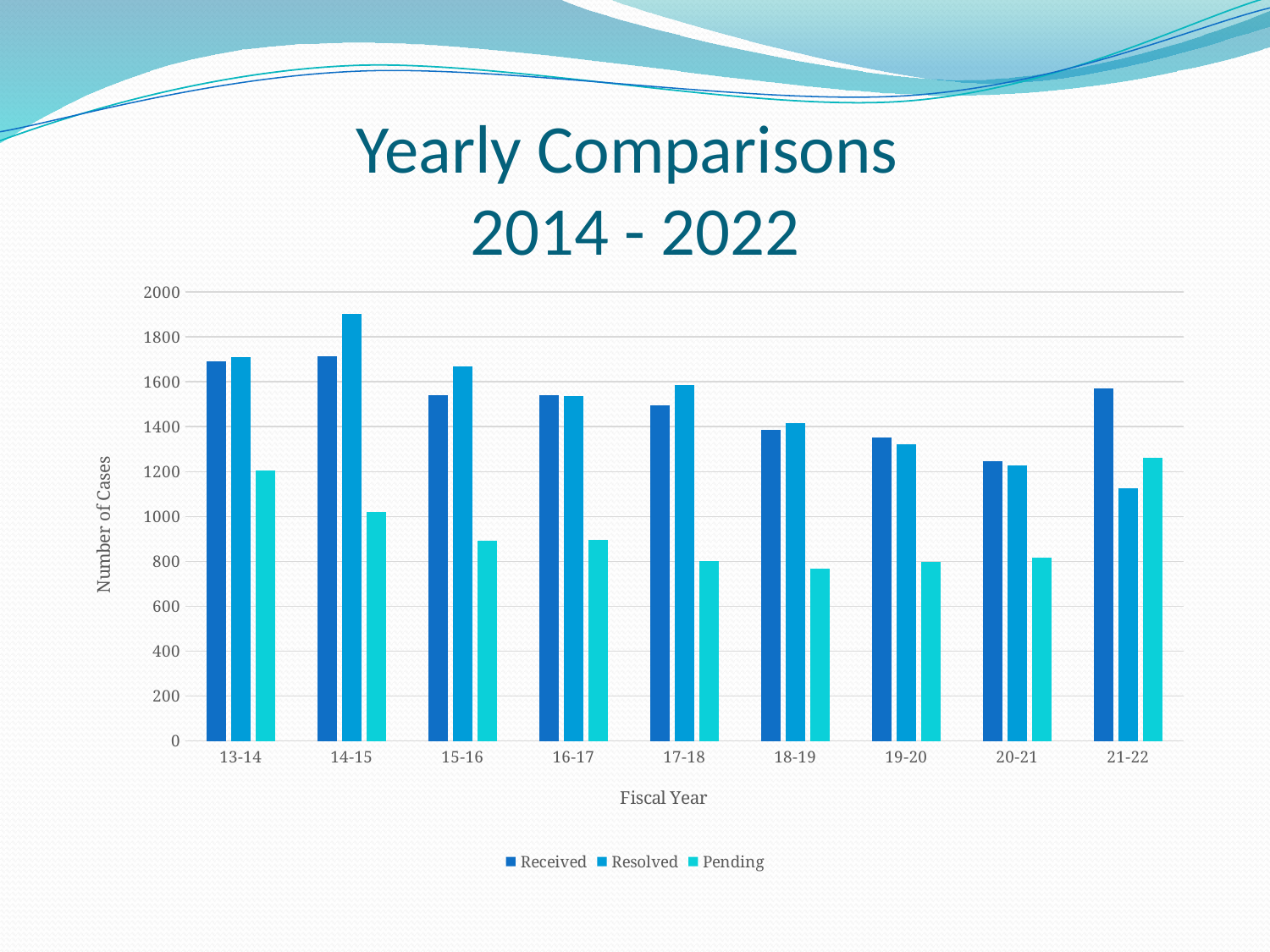
Is the Resolved value for 14-15 greater or less than 1800? greater Is the Pending value for 15-16 greater or less than 1000? less Does the Received value generally rise or fall from 13-14 to 20-21? Fall Is the Received value for 21-22 greater or less than 1400? greater What is the title of the vertical axis? Number of Cases How many fiscal years are shown on the x axis? 9 How many series does the legend list? 3 In which fiscal year is the Pending value highest? 21-22 In which fiscal year is the Resolved value lowest? 21-22 In which fiscal year is the Resolved value highest? 14-15 What kind of chart is shown on the slide? Bar chart In fiscal year 21-22, which is larger, Received or Resolved? Received